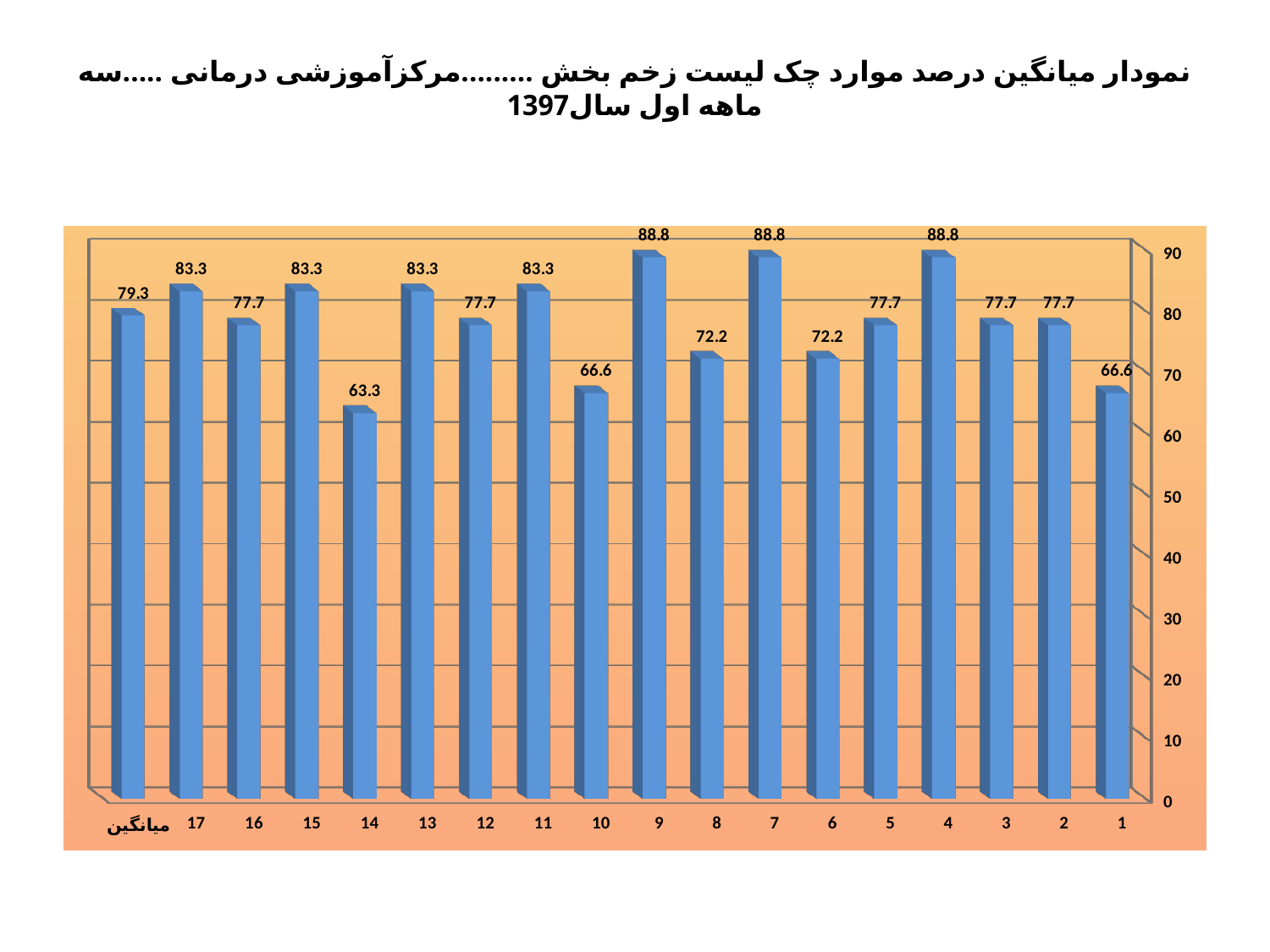
What is the value for category 9? 88.8 What is the maximum value shown on the vertical axis? 90 What is the difference between the values for category 4 and category 14? 25.5 Which is larger, the value for category 6 or the value for category 5? category 5 What is the highest value shown on the chart? 88.8 How many bars are plotted on the chart? 18 What is the value for category 1? 66.6 Which category has the lowest value? 14 What is the value for category 14? 63.3 What is the difference between the values for category 17 and category 16? 5.6 What is the value shown for میانگین (the average bar)? 79.3 What kind of chart is shown on the slide? bar chart